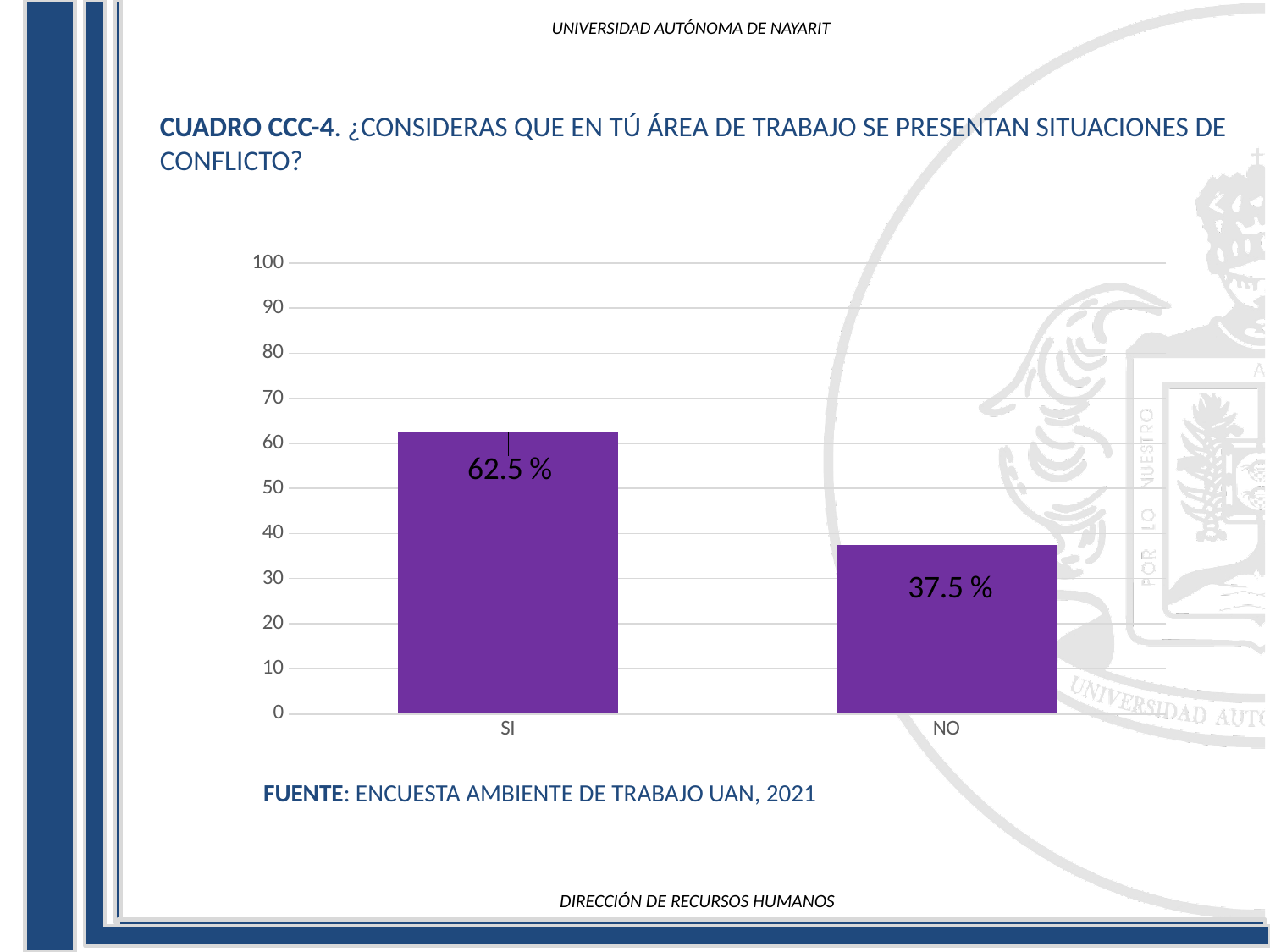
Is the value for SI greater or less than 50? greater What is the highest value shown on the y axis? 100 What is the value for SI? 62.5 % What kind of chart is shown on the slide? bar chart What colour are the bars in the chart? purple Is the value for NO greater or less than 40? less What is the difference between the values for SI and NO? 25 % Which is larger, the value for SI or the value for NO? SI How many categories are shown on the x axis? 2 Which category has the highest value? SI What is the value for NO? 37.5 % Which category has the lowest value? NO